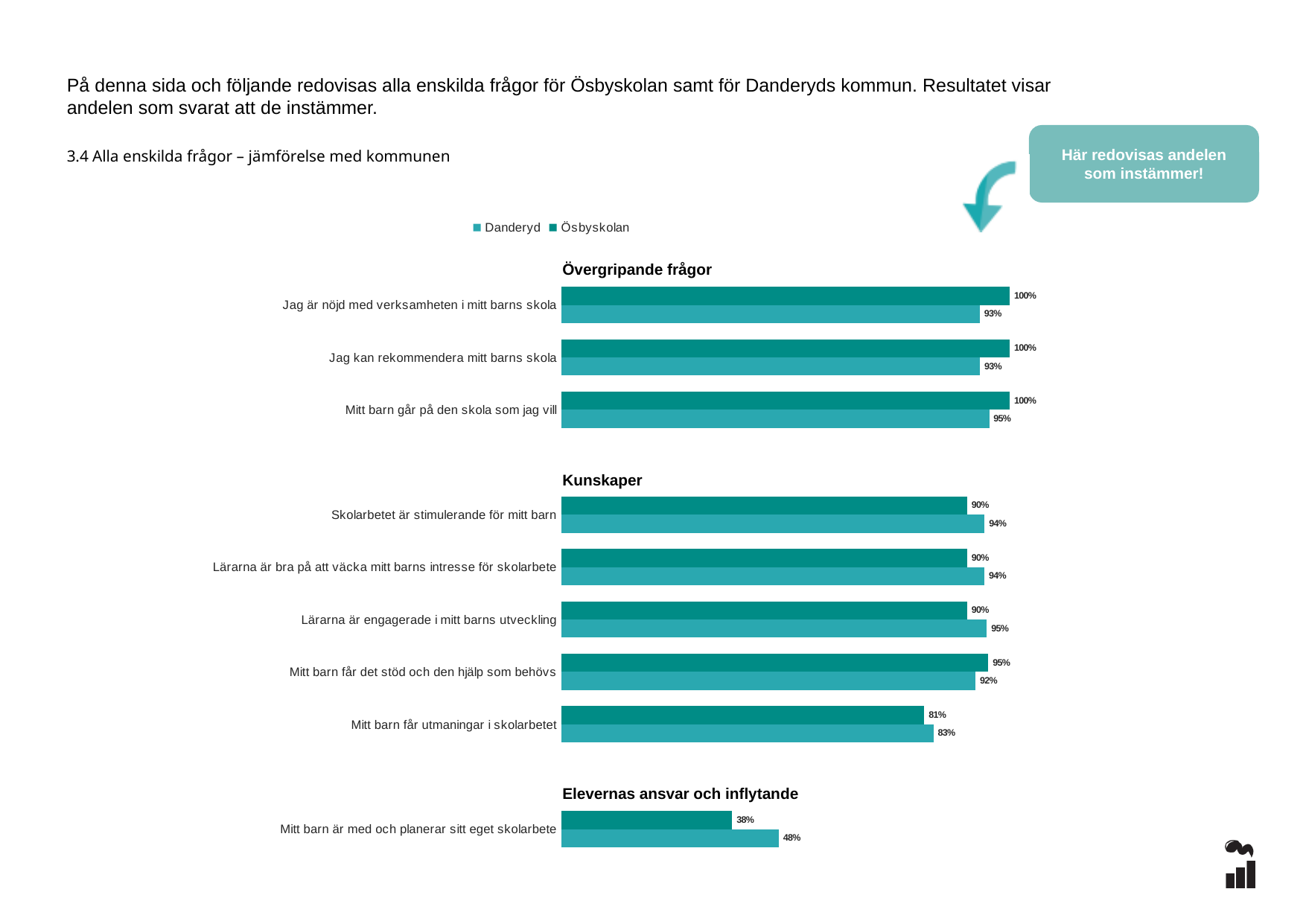
What is the Danderyd value for "Mitt barn går på den skola som jag vill"? 95% What is the Ösbyskolan value for "Mitt barn får utmaningar i skolarbetet"? 81% What kind of chart is shown on the slide? Bar chart How many questions (categories) are shown in the chart? 9 What is the difference between the Danderyd and Ösbyskolan values for "Mitt barn är med och planerar sitt eget skolarbete"? 10% What is the Ösbyskolan value for "Jag är nöjd med verksamheten i mitt barns skola"? 100% For "Mitt barn får det stöd och den hjälp som behövs", which is larger, the Ösbyskolan value or the Danderyd value? Ösbyskolan What is the difference between the Ösbyskolan and Danderyd values for "Jag kan rekommendera mitt barns skola"? 7% What is the Danderyd value for "Mitt barn är med och planerar sitt eget skolarbete"? 48% For "Lärarna är engagerade i mitt barns utveckling", which is larger, the Danderyd value or the Ösbyskolan value? Danderyd How many series does the legend list? 2 Which question has the lowest Ösbyskolan value? Mitt barn är med och planerar sitt eget skolarbete